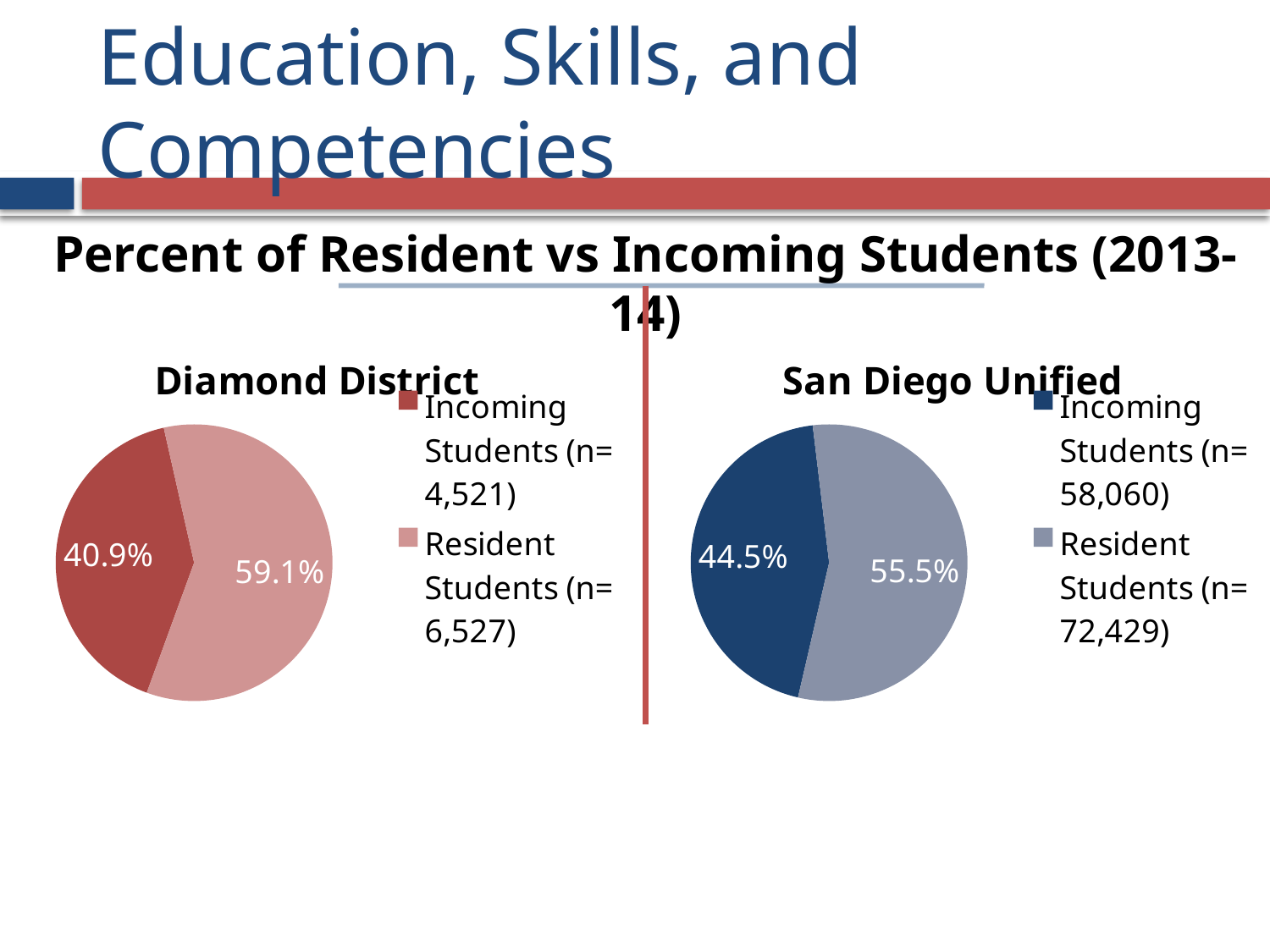
In the San Diego Unified pie chart, what percentage is shown for Resident Students? 55.5% How many slices does the San Diego Unified pie chart have? 2 In the Diamond District pie chart, which slice is the largest? Resident Students In the San Diego Unified pie chart, what is the difference in percentage points between Resident Students and Incoming Students? 11 In the Diamond District pie chart, what is the difference in percentage points between Resident Students and Incoming Students? 18.2 Which is larger: the Incoming Students share in the Diamond District chart or the Incoming Students share in the San Diego Unified chart? San Diego Unified In the San Diego Unified pie chart, which slice is the smallest? Incoming Students In the Diamond District pie chart, what percentage is shown for Resident Students? 59.1% In the San Diego Unified chart legend, what is the n value given for Resident Students? 72,429 In the Diamond District pie chart, what percentage is shown for Incoming Students? 40.9% In the San Diego Unified pie chart, what percentage is shown for Incoming Students? 44.5% What type of chart is used for the Diamond District data? Pie chart